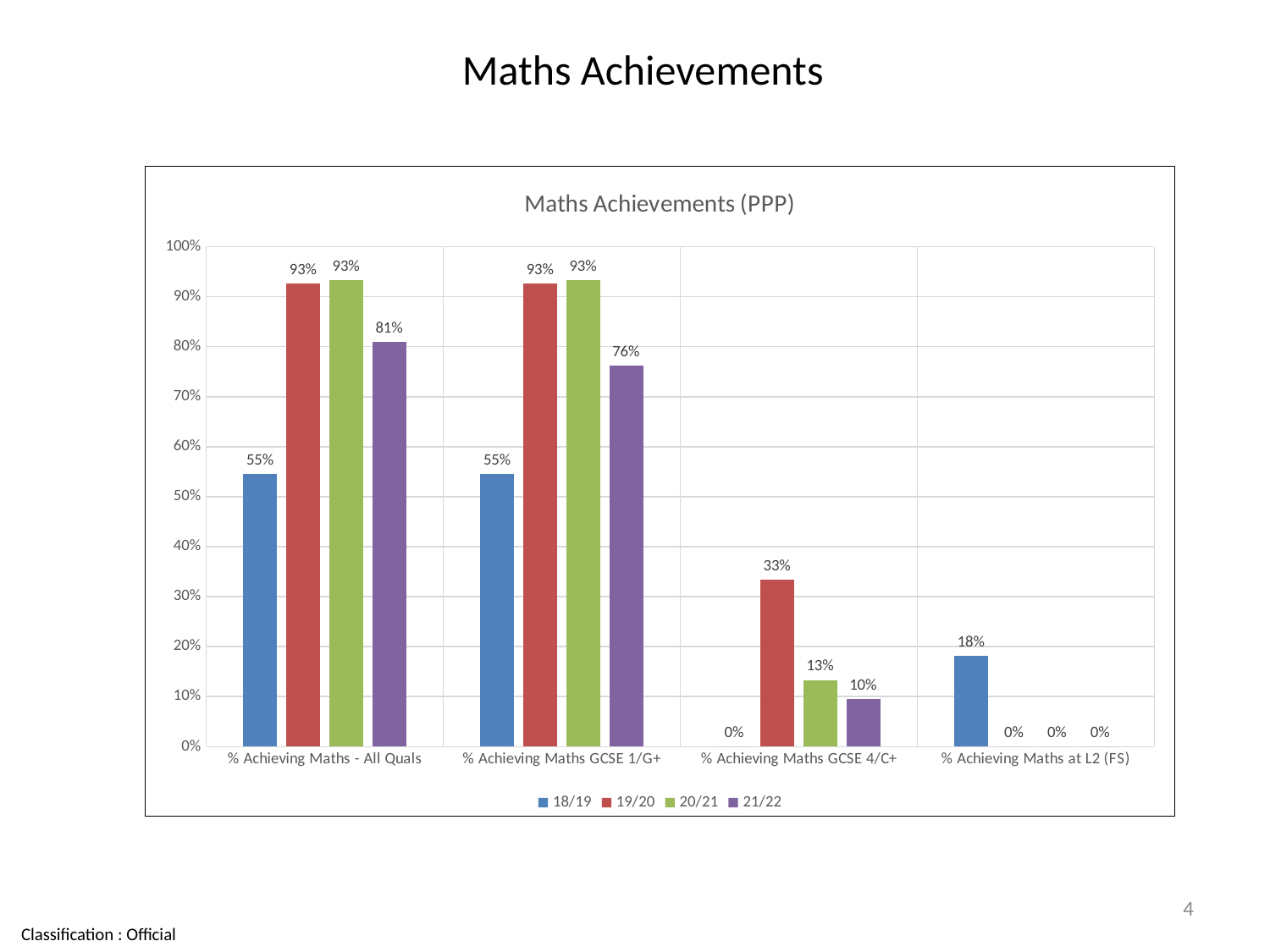
How many categories are shown on the x axis? 4 What is the value for 21/22 in the '% Achieving Maths GCSE 1/G+' category? 76% What is the value for 21/22 in the '% Achieving Maths - All Quals' category? 81% What is the value for 18/19 in the '% Achieving Maths at L2 (FS)' category? 18% What is the difference between the 19/20 and 18/19 values in the '% Achieving Maths - All Quals' category? 38% How many series does the legend list? 4 What kind of chart is shown on the slide? Bar chart Which series has the highest value in the '% Achieving Maths GCSE 4/C+' category? 19/20 Which is larger in the '% Achieving Maths GCSE 4/C+' category: the 20/21 value or the 21/22 value? 20/21 What is the value for 19/20 in the '% Achieving Maths GCSE 4/C+' category? 33% What is the title of the chart? Maths Achievements (PPP) Which series has the lowest value in the '% Achieving Maths - All Quals' category? 18/19